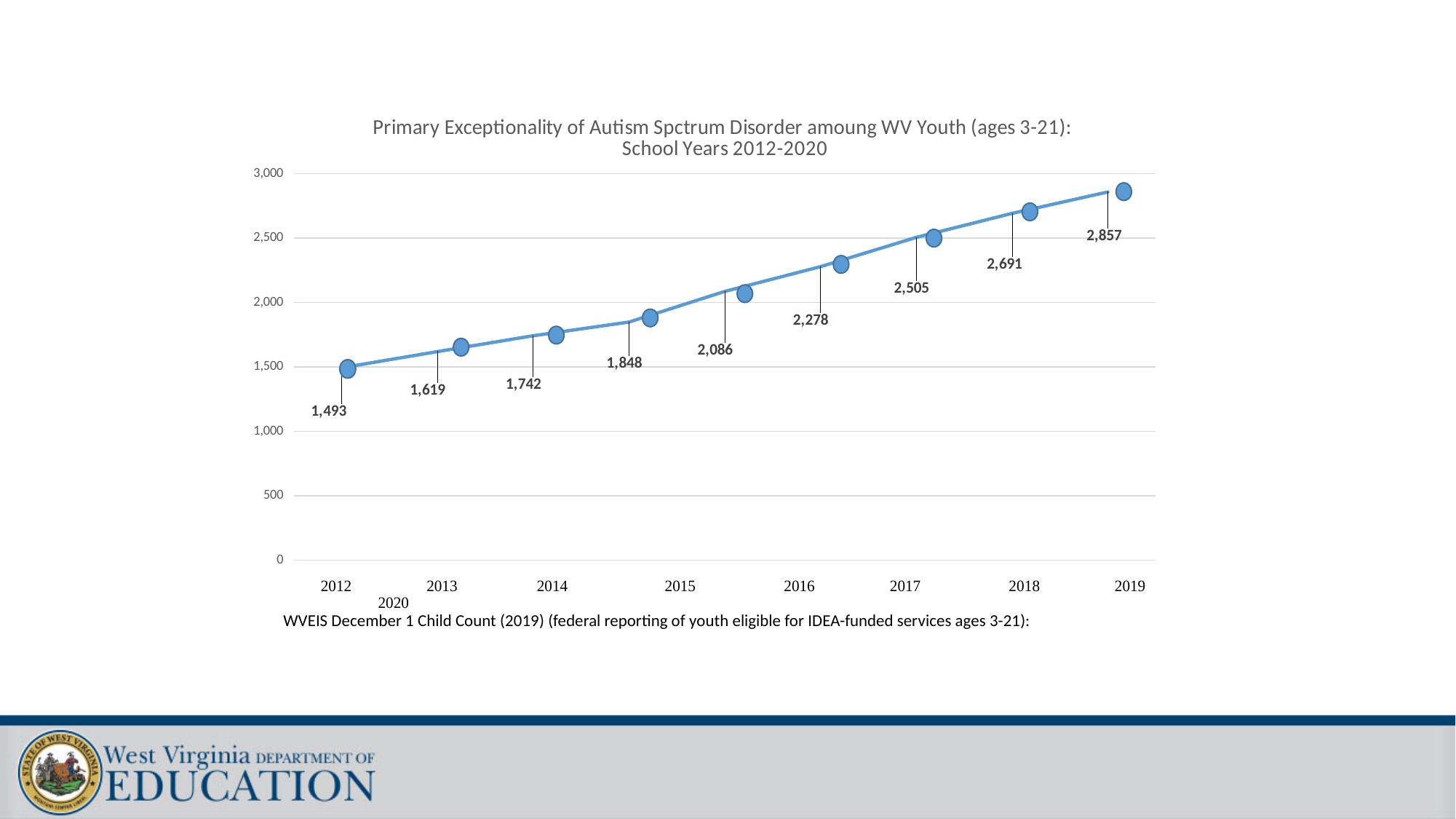
What is the highest value plotted on the chart? 2,857 What is the lowest value plotted on the chart? 1,493 How many data points are plotted on the line? 9 What is the difference between the highest value (2,857) and the lowest value (1,493) on the chart? 1,364 Do the values rise or fall from left to right along the x axis? rise Is the value of the first data point (1,493) greater or less than 1,500? less What is the difference between the data points labeled 2,505 and 2,278? 227 Which is larger, the data point labeled 2,086 or the one labeled 1,848? 2,086 What is the title of the chart? Primary Exceptionality of Autism Spctrum Disorder amoung WV Youth (ages 3-21): School Years 2012-2020 What is the value of the last (rightmost) data point on the line? 2,857 What is the value of the first (leftmost) data point on the line? 1,493 What kind of chart is shown on the slide? line chart